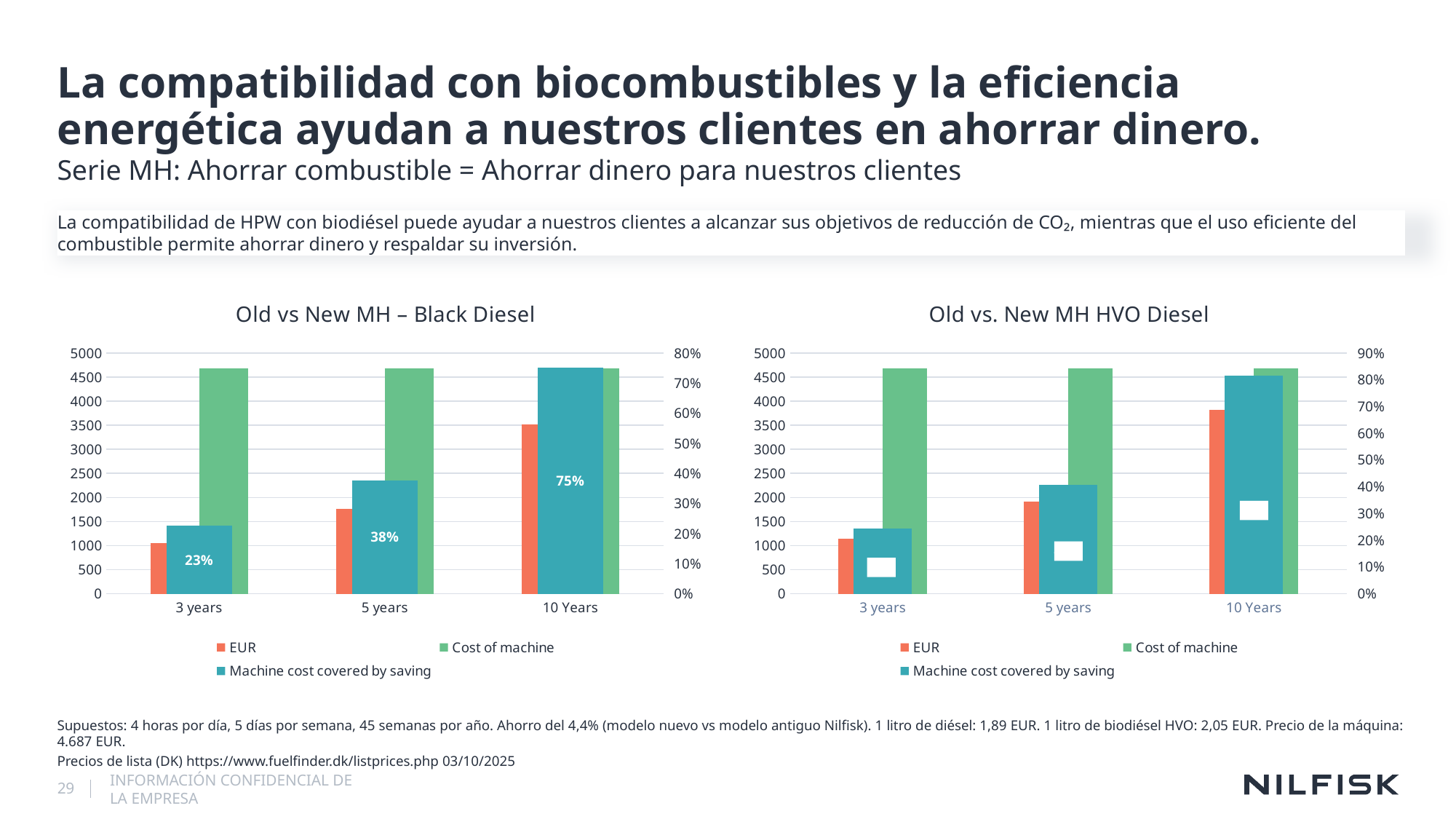
In the 'Old vs New MH – Black Diesel' chart, what is the value of 'Machine cost covered by saving' at 3 years? 23% In the 'Old vs. New MH HVO Diesel' chart, is the EUR value for 10 Years greater or less than 3500? greater How many series does the legend of the 'Old vs. New MH HVO Diesel' chart list? 3 In the 'Old vs New MH – Black Diesel' chart, does the 'Machine cost covered by saving' value rise or fall from 3 years to 10 Years? rise In the 'Old vs New MH – Black Diesel' chart, what is the value of 'Machine cost covered by saving' at 10 Years? 75% In the 'Old vs. New MH HVO Diesel' chart, is the EUR value for 3 years greater or less than 1500? less In the 'Old vs New MH – Black Diesel' chart, what is the difference between the 'Machine cost covered by saving' values at 10 Years and 3 years? 52% In the 'Old vs. New MH HVO Diesel' chart, which has the larger EUR value, 3 years or 10 Years? 10 Years How many categories are shown on the x axis of the 'Old vs. New MH HVO Diesel' chart? 3 In the 'Old vs New MH – Black Diesel' chart, which period has the highest 'Machine cost covered by saving' value? 10 Years What kind of chart is the 'Old vs New MH – Black Diesel' chart? bar chart In the 'Old vs New MH – Black Diesel' chart, what is the value of 'Machine cost covered by saving' at 5 years? 38%